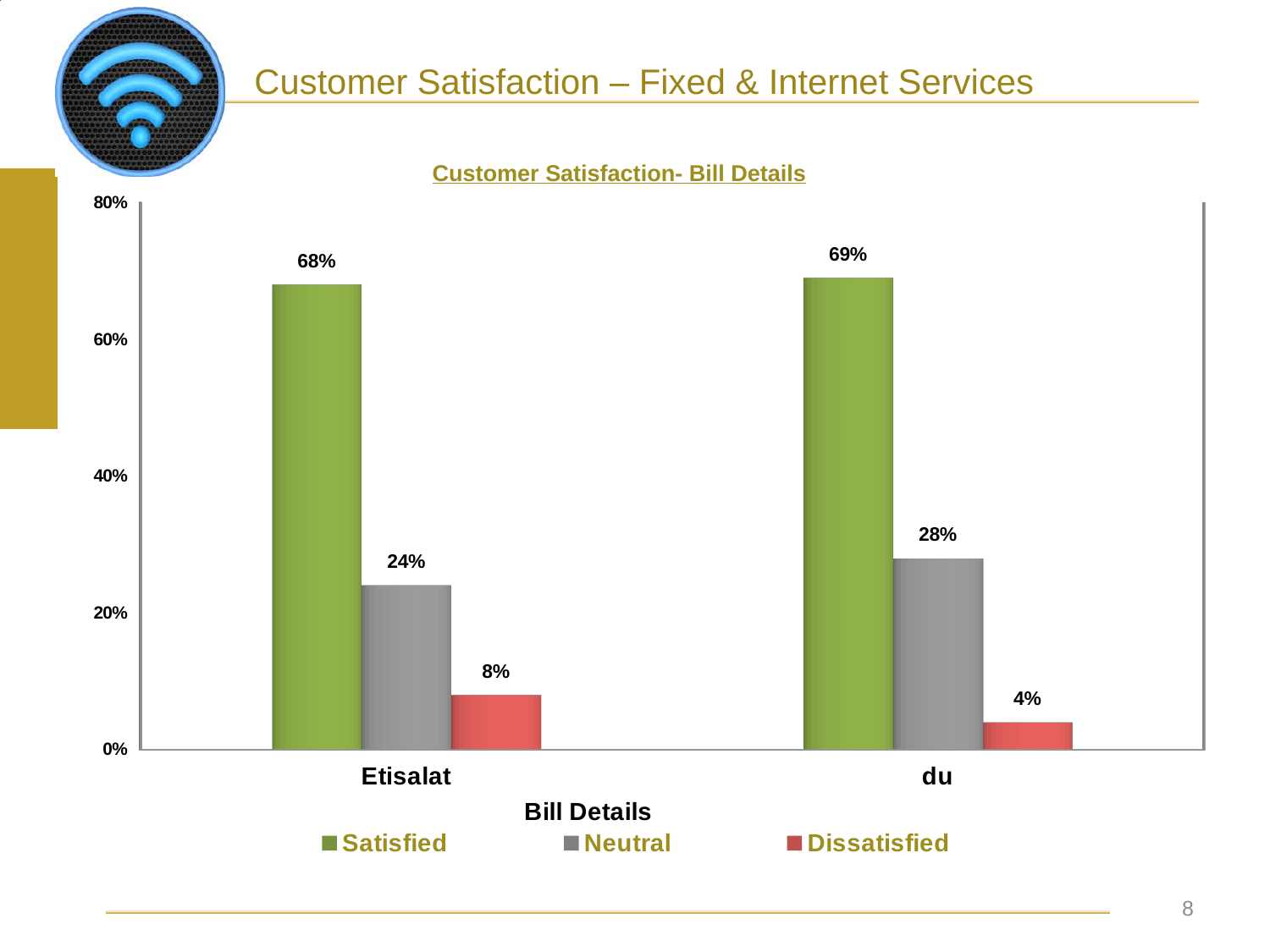
What is the Neutral value for du? 28% Which category has the highest Satisfied value? du How many categories are shown on the x axis? 2 What is the Dissatisfied value for Etisalat? 8% What is the title of the chart? Customer Satisfaction- Bill Details Which category has the lowest Dissatisfied value? du How many series does the legend list? 3 What is the difference between the Neutral values for du and Etisalat? 4% What is the Dissatisfied value for du? 4% Which is larger, the Dissatisfied value for Etisalat or for du? Etisalat What is the Satisfied value for Etisalat? 68% What kind of chart is shown? bar chart